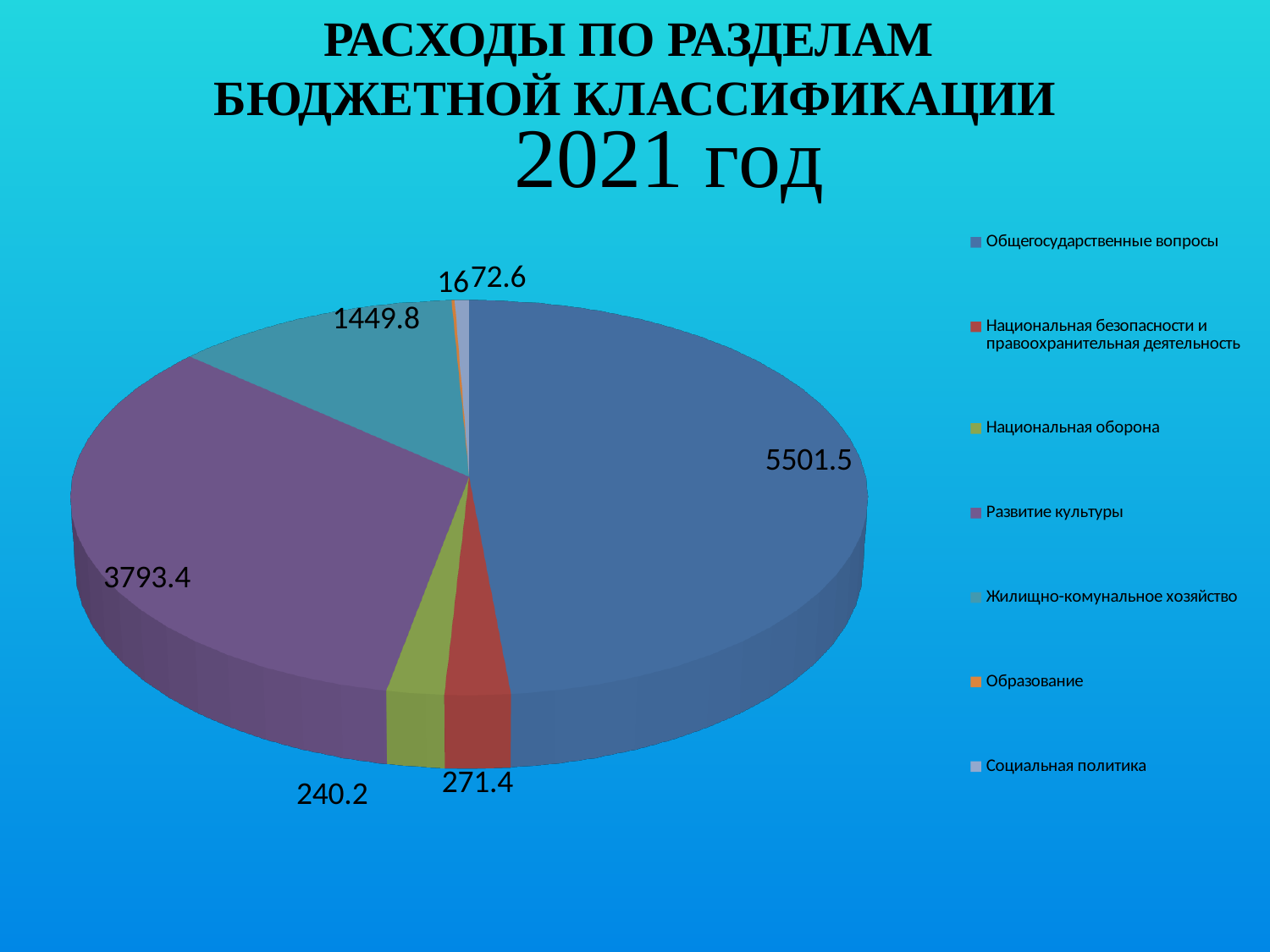
What is the value for Жилищно-коммунальное хозяйство? 1449.8 What is the value for Национальная оборона? 240.2 Which is larger, the value for Национальная безопасности и правоохранительная деятельность or the value for Национальная оборона? Национальная безопасности и правоохранительная деятельность What type of chart is shown on the slide? Pie chart Which category has the largest slice of the pie? Общегосударственные вопросы What is the value for Общегосударственные вопросы? 5501.5 What is the value for Национальная безопасности и правоохранительная деятельность? 271.4 How many categories does the legend list? 7 What is the value for Развитие культуры? 3793.4 Which year does the chart title refer to? 2021 год What is the difference between the values for Развитие культуры and Жилищно-коммунальное хозяйство? 2343.6 What is the difference between the values for Общегосударственные вопросы and Развитие культуры? 1708.1